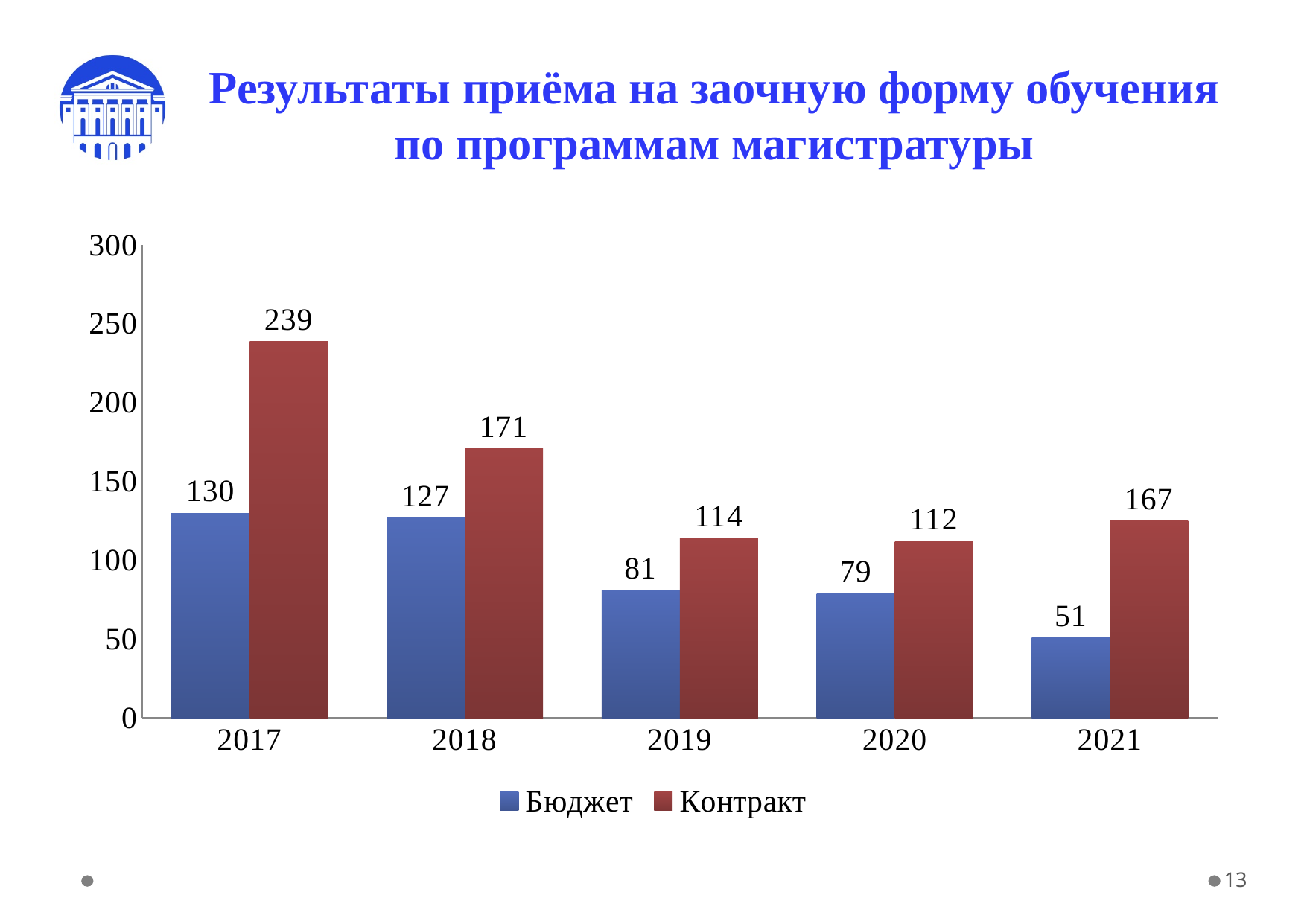
Is the value for Контракт in 2017 greater or less than 200? greater What is the difference between Контракт and Бюджет in 2018? 44 What is the value for Контракт in 2021? 167 What is the value for Бюджет in 2017? 130 How many years are shown on the x axis? 5 What kind of chart is shown on the slide? bar chart In which year is the Контракт value highest? 2017 In which year is the Бюджет value lowest? 2021 Which is larger in 2020: Бюджет or Контракт? Контракт Does the Бюджет value rise or fall from 2017 to 2021? fall What is the value for Контракт in 2019? 114 How many series does the legend list? 2